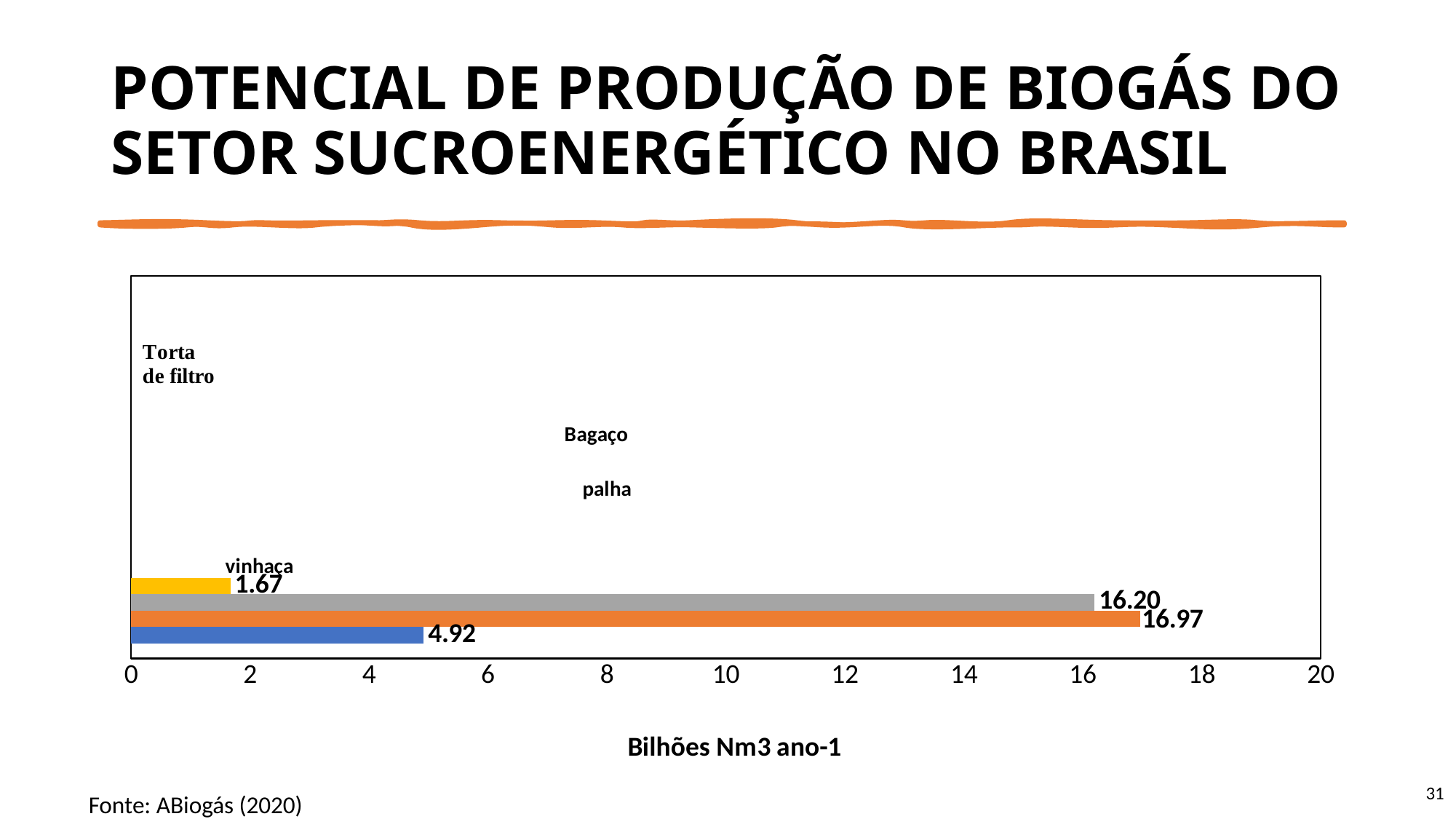
How many bars are plotted in the chart? 4 What is the difference between the blue bar (4.92) and the yellow bar (1.67)? 3.25 What is the value of the gray bar? 16.20 What is the lowest value shown in the chart? 1.67 What is the highest value shown in the chart? 16.97 Which is larger, the orange bar or the gray bar? the orange bar What kind of chart is shown on the slide? bar chart What is the value of the blue bar? 4.92 What is the difference between the orange bar (16.97) and the gray bar (16.20)? 0.77 What is the value of the yellow bar? 1.67 What is the value of the orange bar? 16.97 What unit is given on the x axis of the chart? Bilhões Nm3 ano-1